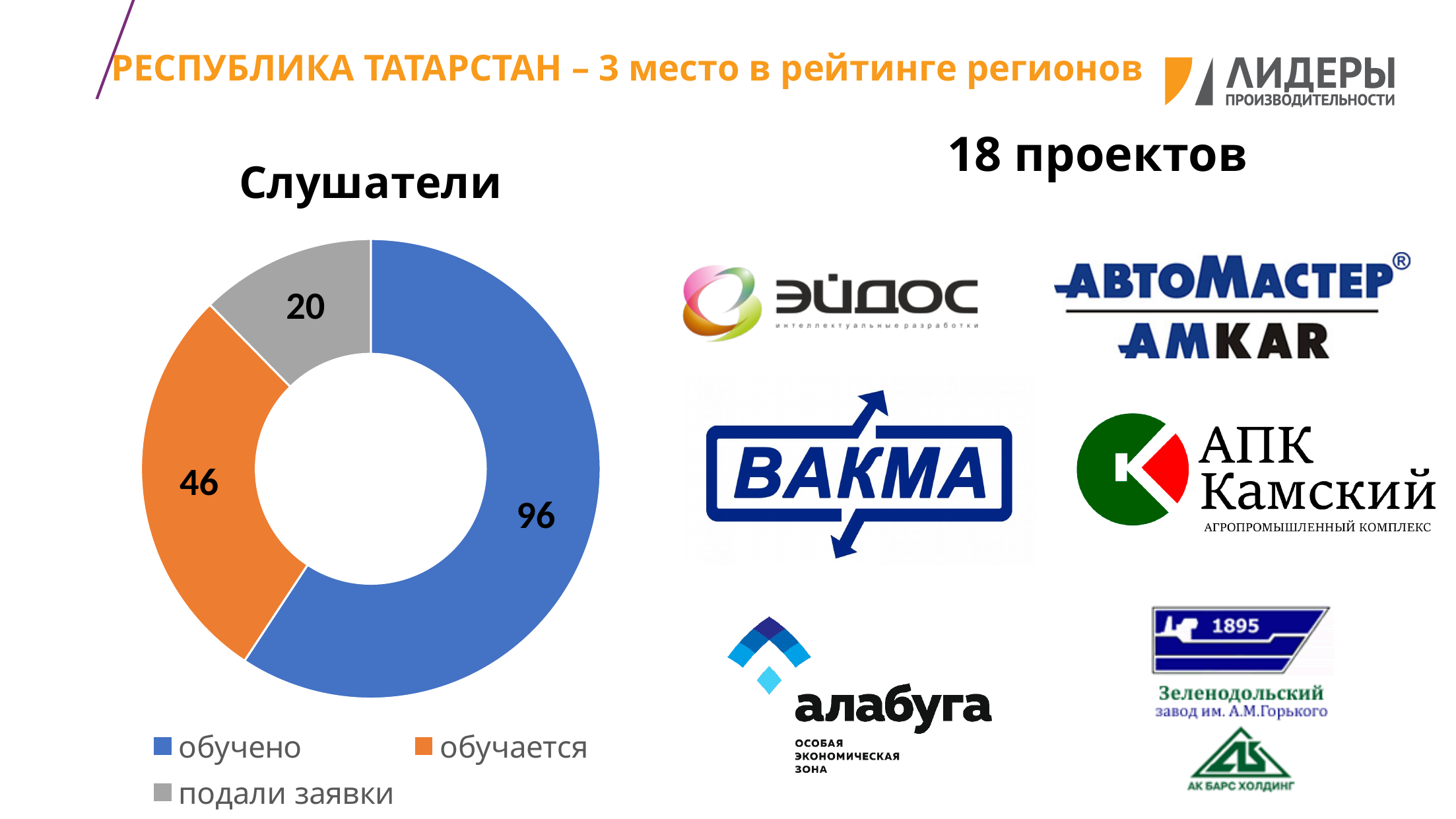
What is the title of the chart on the slide? Слушатели Which category has the lowest value in the Слушатели chart? подали заявки What kind of chart is the Слушатели chart? doughnut chart What is the value for подали заявки in the Слушатели chart? 20 Which category has the highest value in the Слушатели chart? обучено What is the total of all values in the Слушатели chart? 162 What is the value for обучено in the Слушатели chart? 96 What is the difference between обучено and обучается in the Слушатели chart? 50 How many categories does the Слушатели chart show? 3 What colour represents обучается in the Слушатели chart? orange Which is larger in the Слушатели chart, обучается or подали заявки? обучается What is the value for обучается in the Слушатели chart? 46